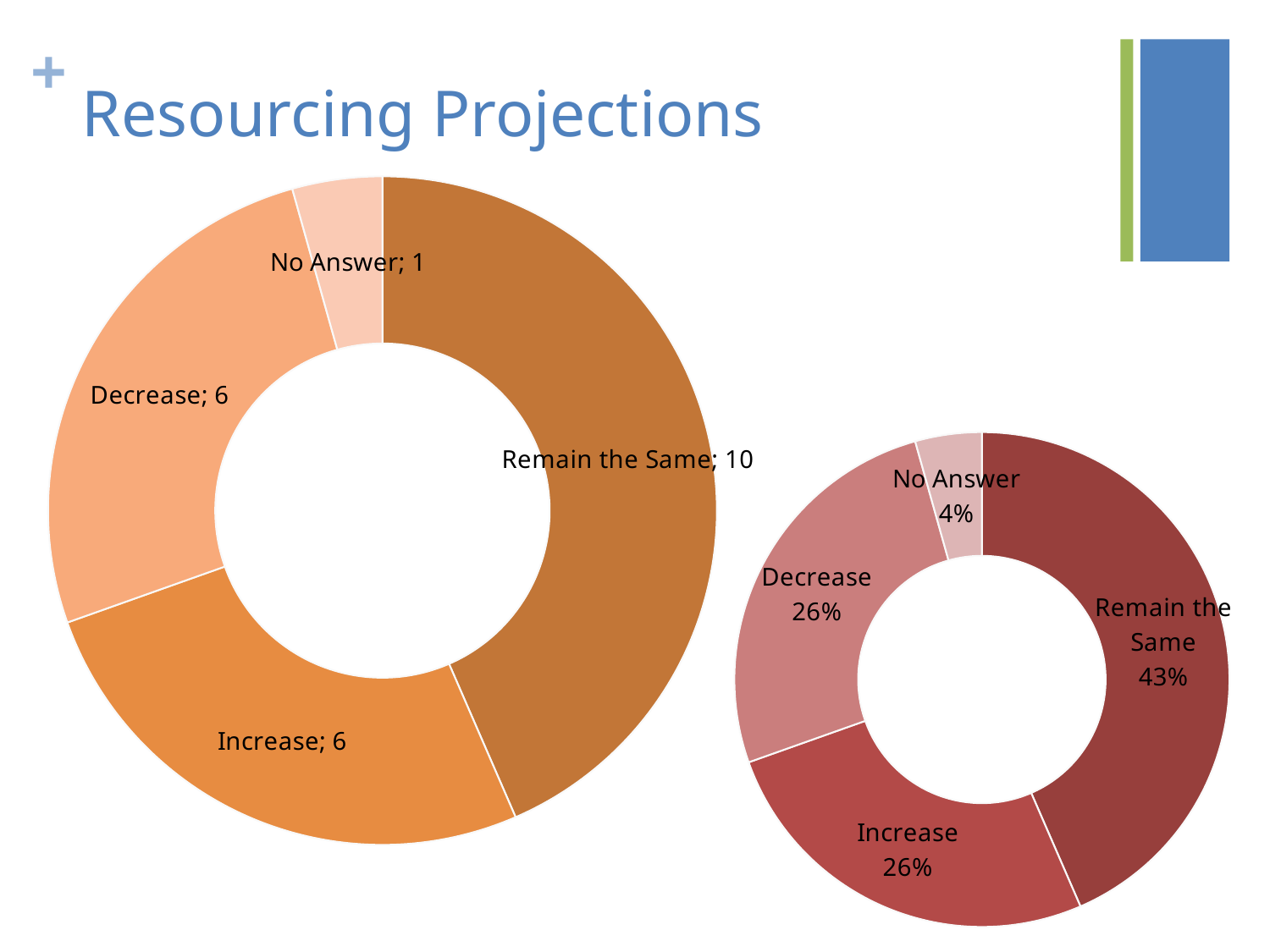
On the right red doughnut chart, which is larger, the share for Decrease or the share for No Answer? Decrease On the left orange doughnut chart, what is the value for Remain the Same? 10 On the right red doughnut chart, what percentage is shown for Remain the Same? 43% On the left orange doughnut chart, what is the difference between the values for Remain the Same and Increase? 4 On the left orange doughnut chart, what is the value for Decrease? 6 On the right red doughnut chart, which category has the smallest share? No Answer On the right red doughnut chart, what percentage is shown for No Answer? 4% What type of chart is the right red chart? Doughnut chart On the left orange doughnut chart, what is the total of all four category values? 23 On the left orange doughnut chart, which category has the largest value? Remain the Same On the left orange doughnut chart, what is the value for No Answer? 1 How many categories does the left orange doughnut chart show? 4